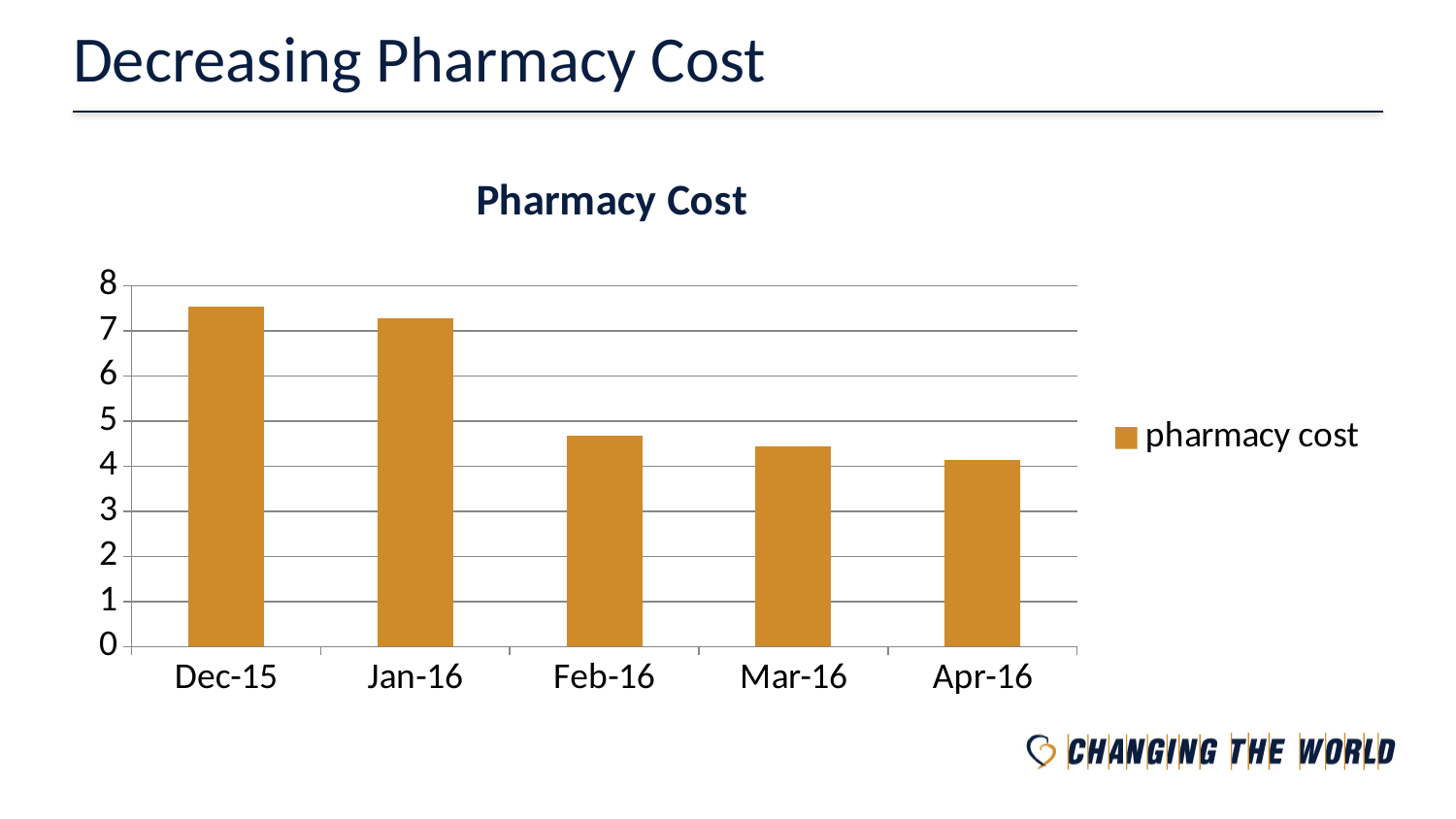
Which is larger, the value for Jan-16 or the value for Mar-16? Jan-16 What kind of chart is shown on the slide? bar chart How many series does the legend list? 1 How many categories are shown on the x axis? 5 Is the value for Feb-16 greater or less than 5? less What is the name of the series shown in the legend? pharmacy cost What is the title of the chart? Pharmacy Cost Do the values rise or fall from Dec-15 to Apr-16? fall Which month has the highest pharmacy cost? Dec-15 Is the value for Dec-15 greater or less than 7? greater Which month has the lowest pharmacy cost? Apr-16